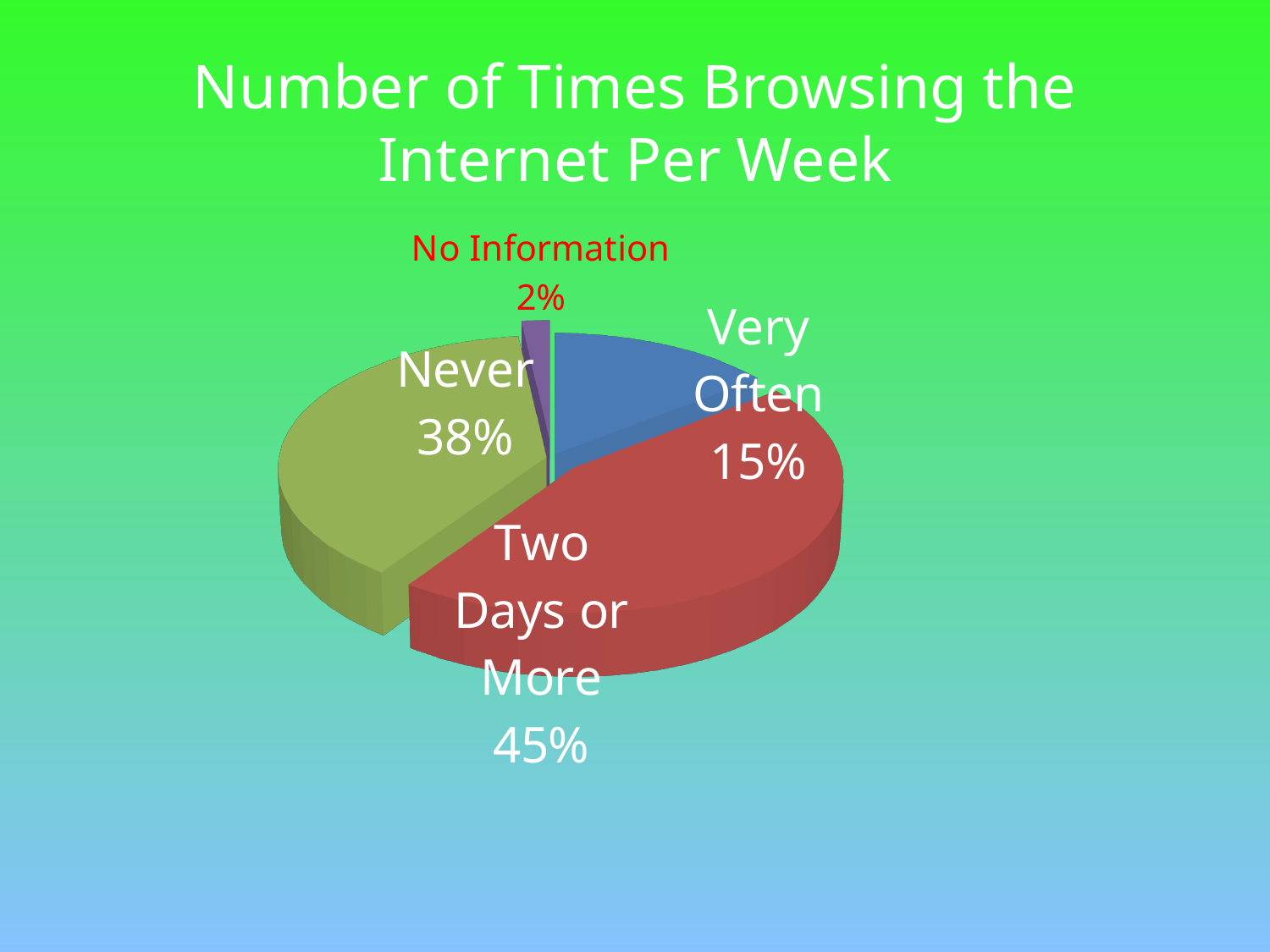
What is the difference in percentage points between "Two Days or More" and "Never"? 7% What percentage is shown for "Two Days or More"? 45% What share of the pie is labelled "Never"? 38% What percentage is shown for "Very Often"? 15% How many slices does the pie chart have? 4 Which category has the smallest slice of the pie? No Information What kind of chart is shown on the slide? Pie chart Which category has the largest slice of the pie? Two Days or More Which is larger, the share for "Never" or the share for "Very Often"? Never What percentage is shown for "No Information"? 2% What colour is the "Never" slice? Green What is the title of the chart? Number of Times Browsing the Internet Per Week